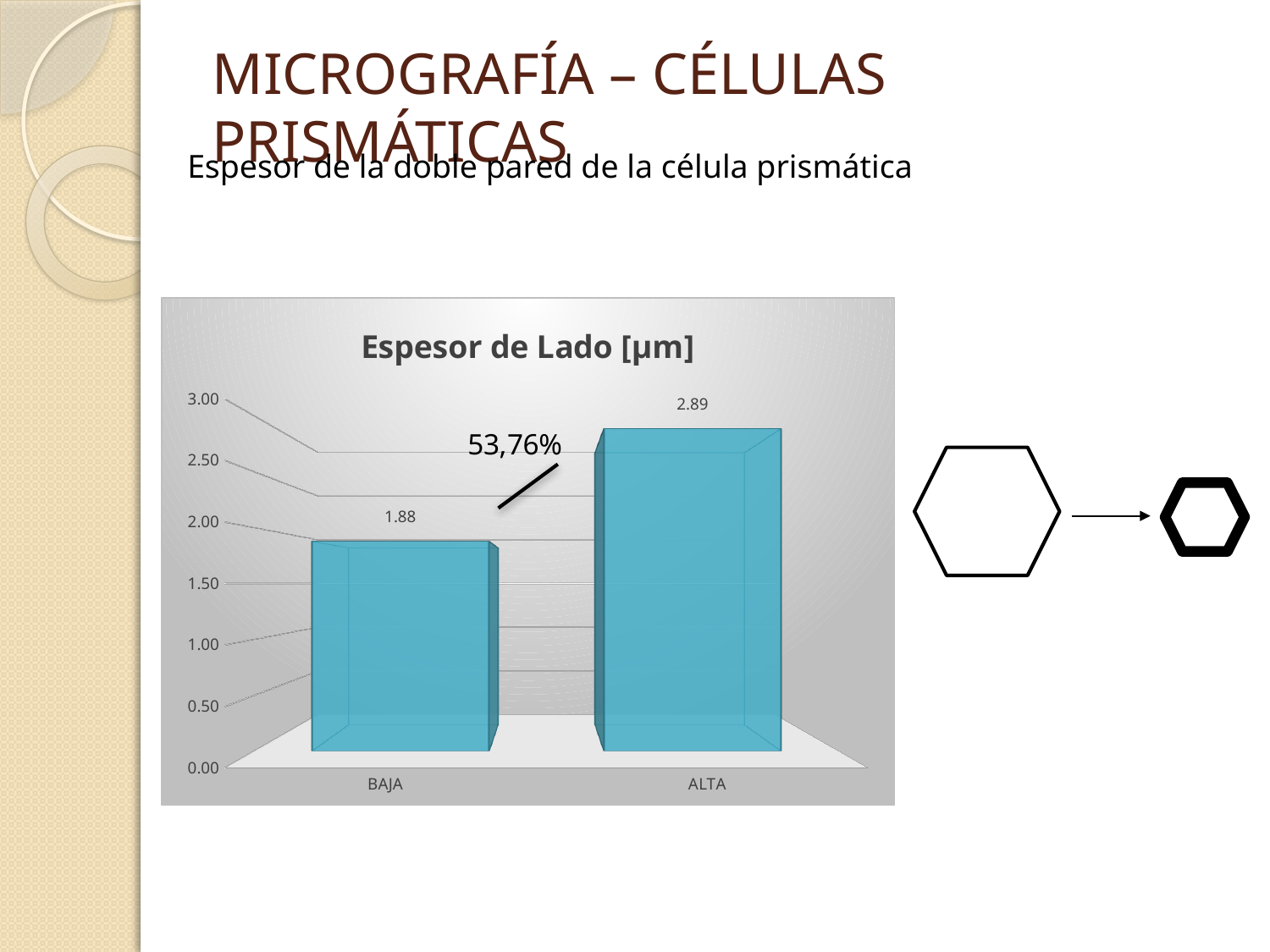
Which category has the lowest value? BAJA What percentage is annotated between the two bars? 53,76% What is the title of the chart? Espesor de Lado [μm] What is the value for BAJA in the chart? 1.88 Which is larger, the value for BAJA or the value for ALTA? ALTA Is the value for ALTA greater or less than 2.50? greater How many categories are shown on the x axis? 2 What is the value for ALTA in the chart? 2.89 What is the difference between the values for ALTA and BAJA? 1.01 Is the value for BAJA greater or less than 2.00? less What kind of chart is shown on the slide? bar chart Which category has the highest value? ALTA